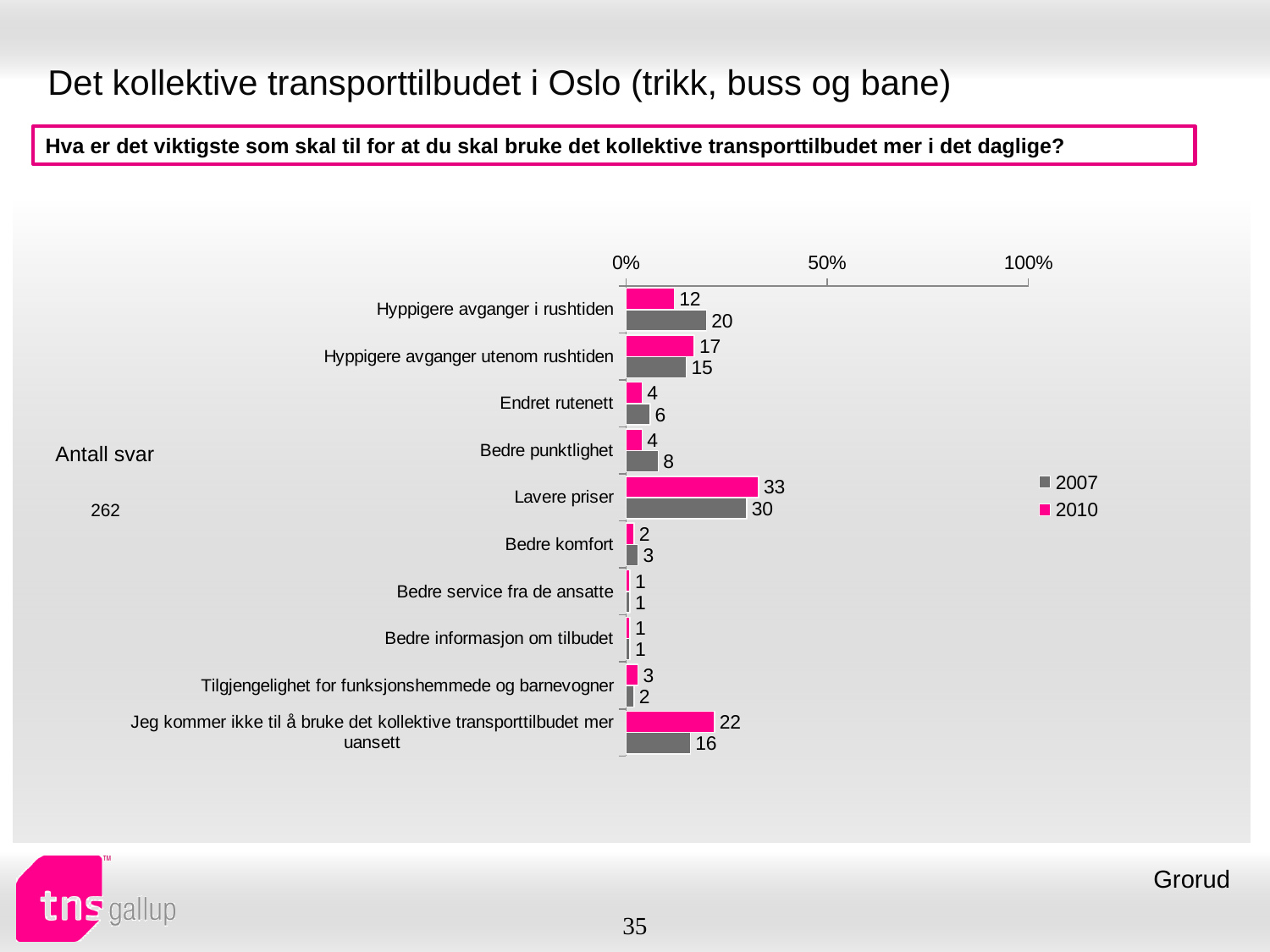
For "Hyppigere avganger utenom rushtiden", which year has the larger value, 2007 or 2010? 2010 What kind of chart is shown on the slide? Bar chart How many categories are shown on the chart? 10 For "Bedre punktlighet", which year has the larger value, 2007 or 2010? 2007 What is the difference between the 2007 and 2010 values for "Hyppigere avganger i rushtiden"? 8 What is the 2010 value for "Lavere priser"? 33 What is the 2007 value for "Hyppigere avganger i rushtiden"? 20 How many series does the legend list? 2 What is the difference between the 2010 and 2007 values for "Jeg kommer ikke til å bruke det kollektive transporttilbudet mer uansett"? 6 Which category has the highest 2010 value? Lavere priser What is the 2010 value for "Jeg kommer ikke til å bruke det kollektive transporttilbudet mer uansett"? 22 Which category has the highest 2007 value? Lavere priser